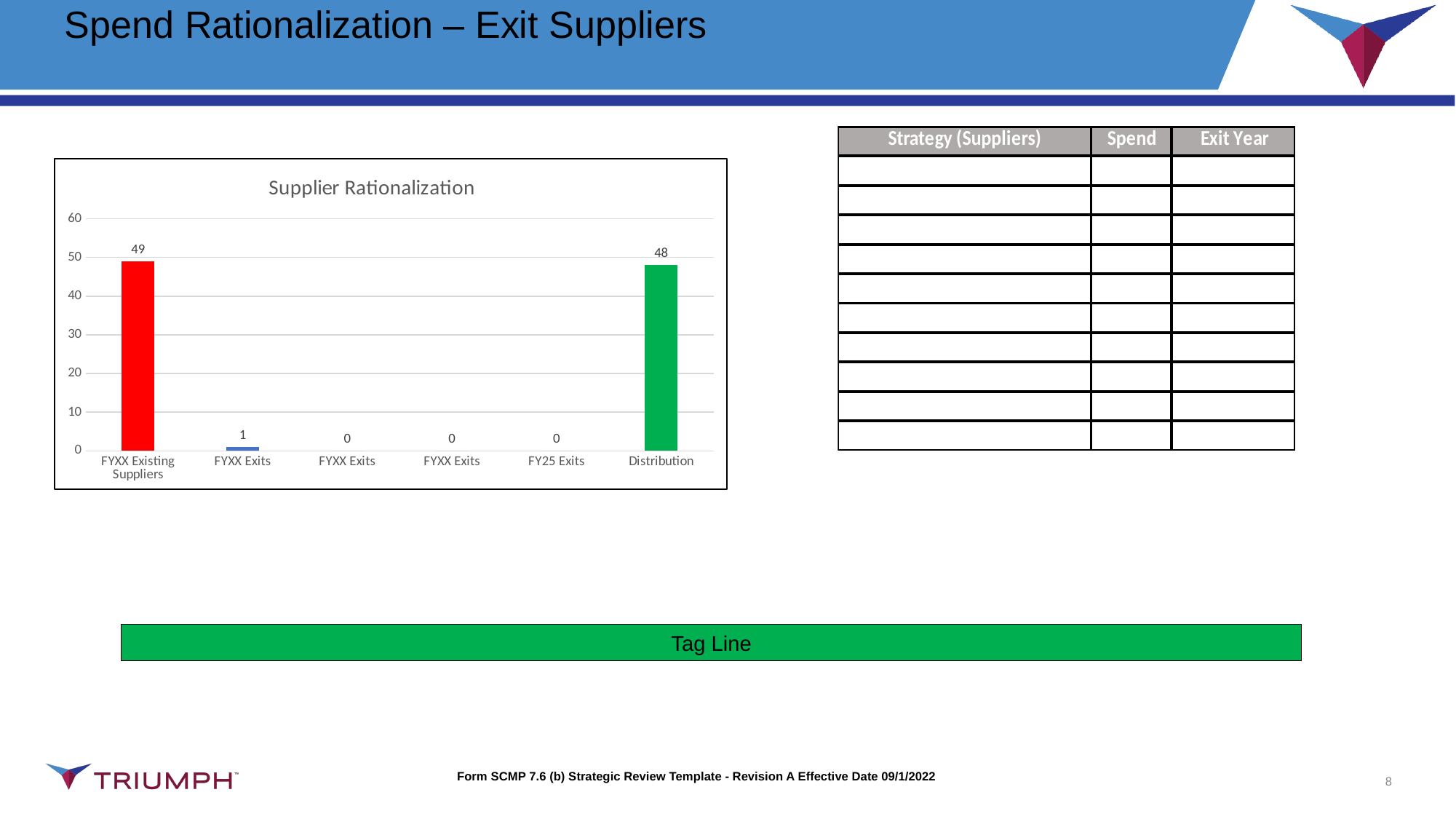
What colour is the bar for FYXX Existing Suppliers? red Which is larger, the value for FYXX Existing Suppliers or the value for Distribution? FYXX Existing Suppliers How many categories in the Supplier Rationalization chart have a value of 0? 3 What is the value for FYXX Existing Suppliers in the Supplier Rationalization chart? 49 What kind of chart is the Supplier Rationalization chart? bar chart How many categories are shown on the x axis of the Supplier Rationalization chart? 6 What is the title of the chart on the slide? Supplier Rationalization Which category has the highest value in the Supplier Rationalization chart? FYXX Existing Suppliers What is the difference between the values for FYXX Existing Suppliers and Distribution? 1 What is the value for FY25 Exits in the Supplier Rationalization chart? 0 What is the value for Distribution in the Supplier Rationalization chart? 48 Is the value for Distribution greater or less than 40? greater